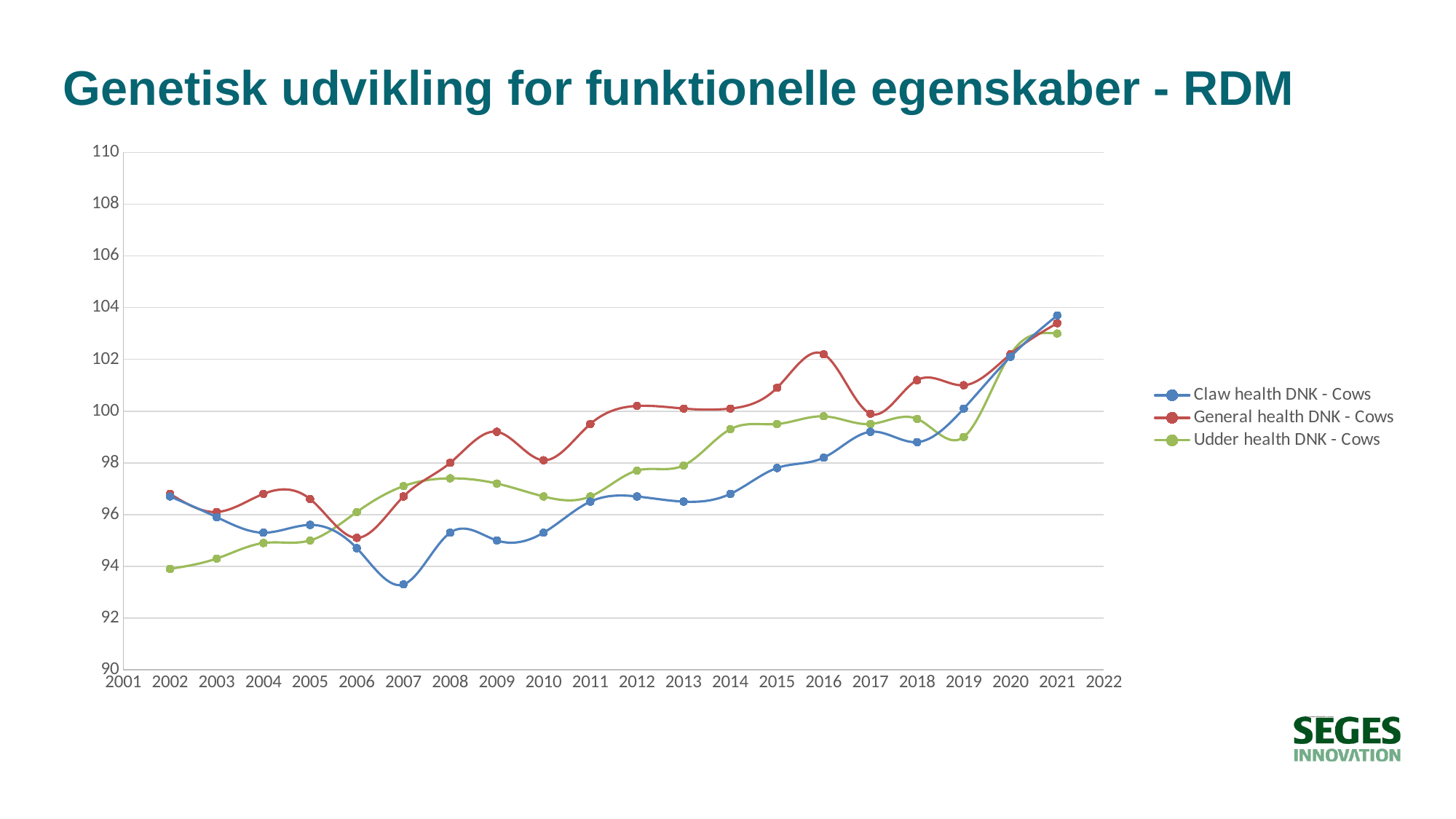
What is the title of the chart slide? Genetisk udvikling for funktionelle egenskaber - RDM How many series does the legend list? 3 Is the value for Udder health DNK - Cows in 2019 greater or less than 100? less Is the value for Claw health DNK - Cows in 2007 greater or less than 94? less What kind of chart is shown on the slide? line chart In which year is the Claw health DNK - Cows series at its highest? 2021 In 2016, which series has the higher value: General health DNK - Cows or Claw health DNK - Cows? General health DNK - Cows Overall, do the values for General health DNK - Cows rise or fall from 2002 to 2021? rise How many yearly data points are plotted for the Claw health DNK - Cows series? 20 In which year is the Claw health DNK - Cows series at its lowest? 2007 In which year is the Udder health DNK - Cows series at its lowest? 2002